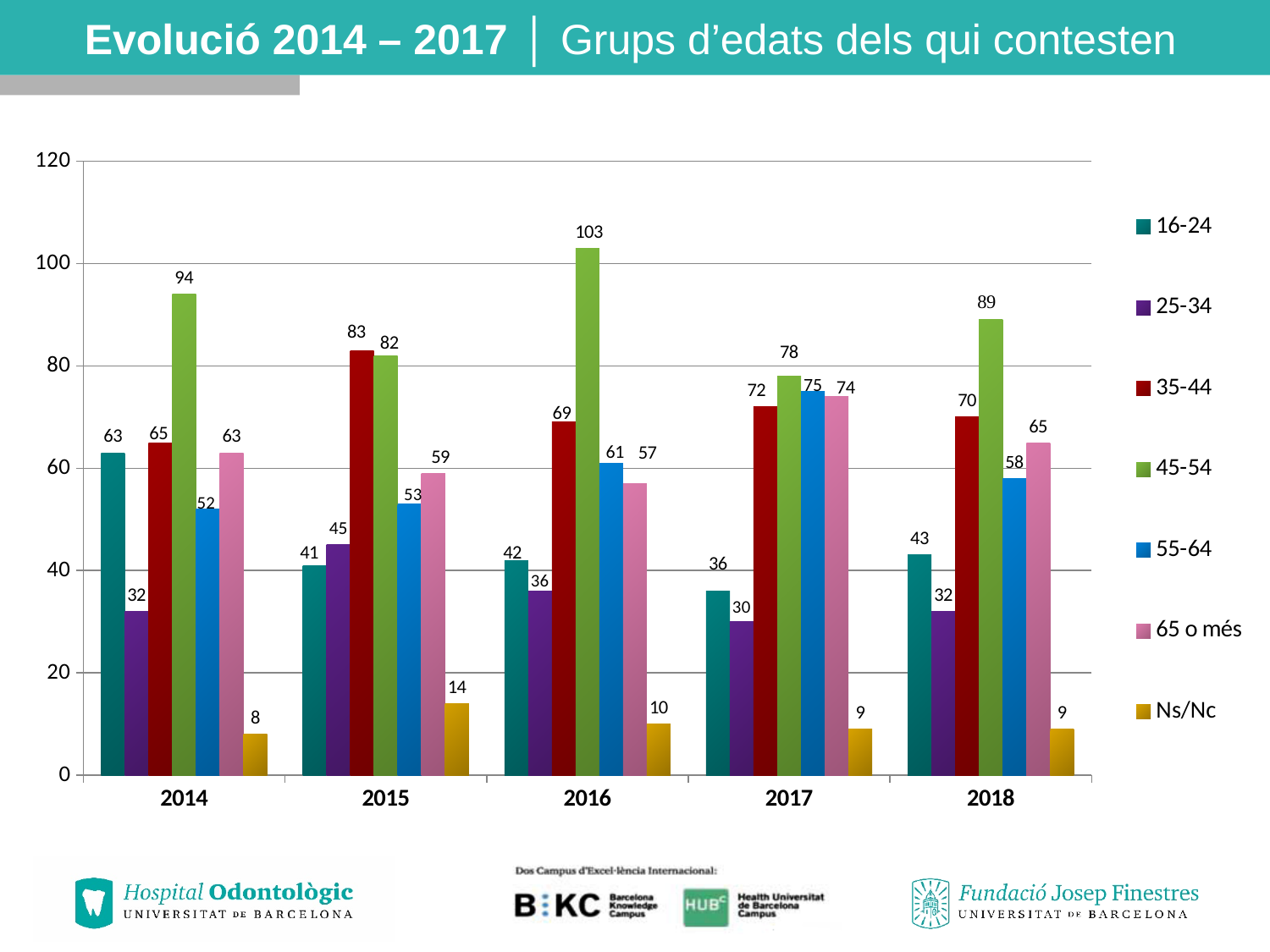
How many series does the legend list? 7 How many years are shown on the x axis? 5 Which age group has the highest value in 2018? 45-54 Which age group has the lowest value in 2017? Ns/Nc Does the value for the 16-24 age group rise or fall from 2014 to 2015? Fall What kind of chart is shown on the slide? Bar chart What is the value for the 35-44 age group in 2015? 83 Is the value for the 25-34 age group in 2015 greater or less than 40? greater What is the value for Ns/Nc in 2014? 8 What is the value for the 45-54 age group in 2016? 103 Which is larger in 2017: the value for 55-64 or the value for 65 o més? 55-64 What is the difference between the 45-54 value in 2016 and the 45-54 value in 2014? 9